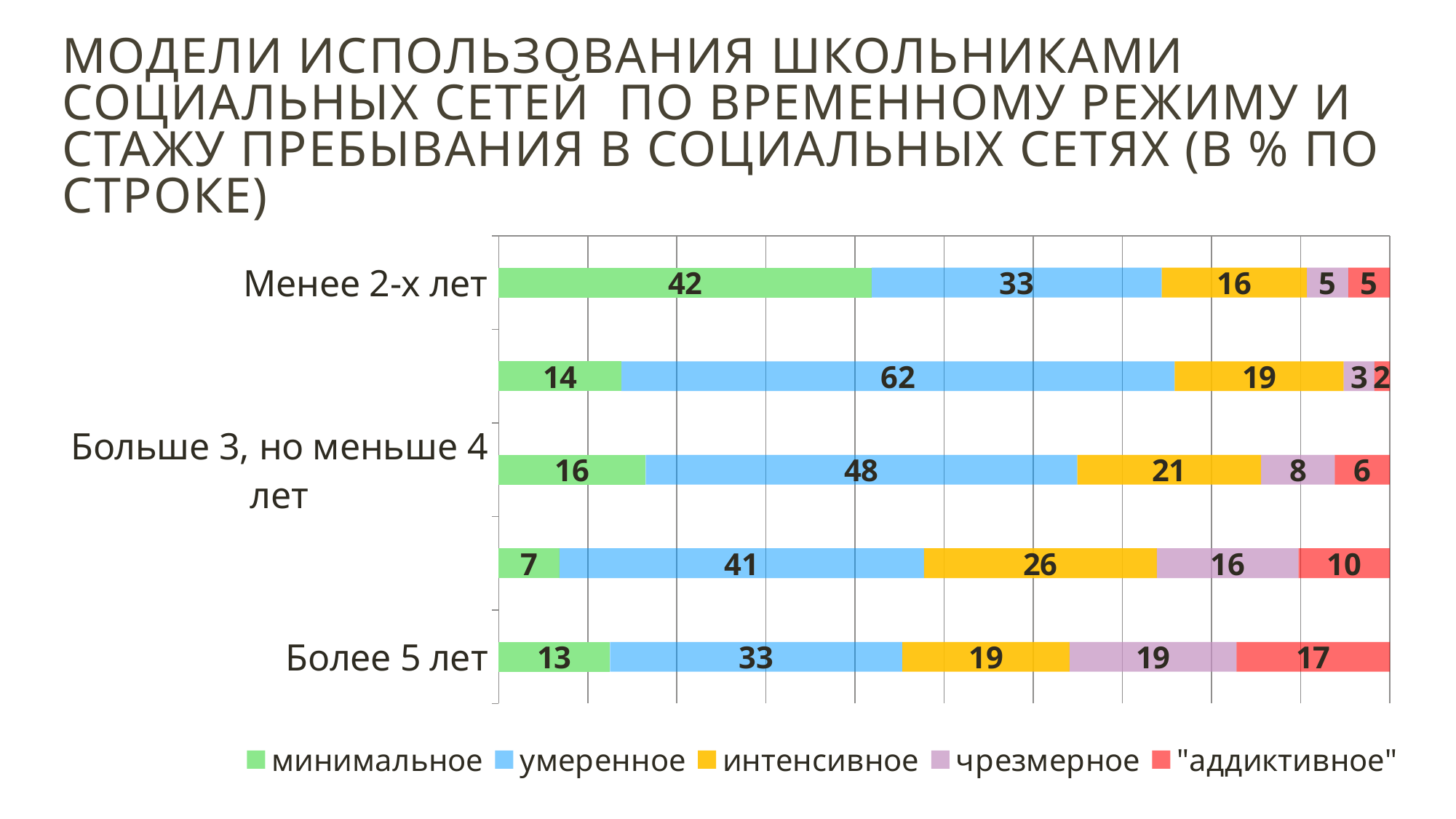
What is the value of "аддиктивное" for "Более 5 лет"? 17 Which series has the largest value in the "Менее 2-х лет" bar? минимальное How many series does the legend list? 5 Which is larger: "интенсивное" for "Больше 3, но меньше 4 лет" or "интенсивное" for "Менее 2-х лет"? Больше 3, но меньше 4 лет What kind of chart is shown on the slide? stacked bar chart What is the value of "умеренное" for "Больше 3, но меньше 4 лет"? 48 What is the total of the stacked bar for "Больше 3, но меньше 4 лет"? 99 Which series has the smallest value in the "Больше 3, но меньше 4 лет" bar? аддиктивное What is the value of "минимальное" for "Менее 2-х лет"? 42 How many bars are plotted in the chart? 5 What is the difference between "минимальное" for "Менее 2-х лет" and "минимальное" for "Более 5 лет"? 29 What is the value of "чрезмерное" for "Более 5 лет"? 19